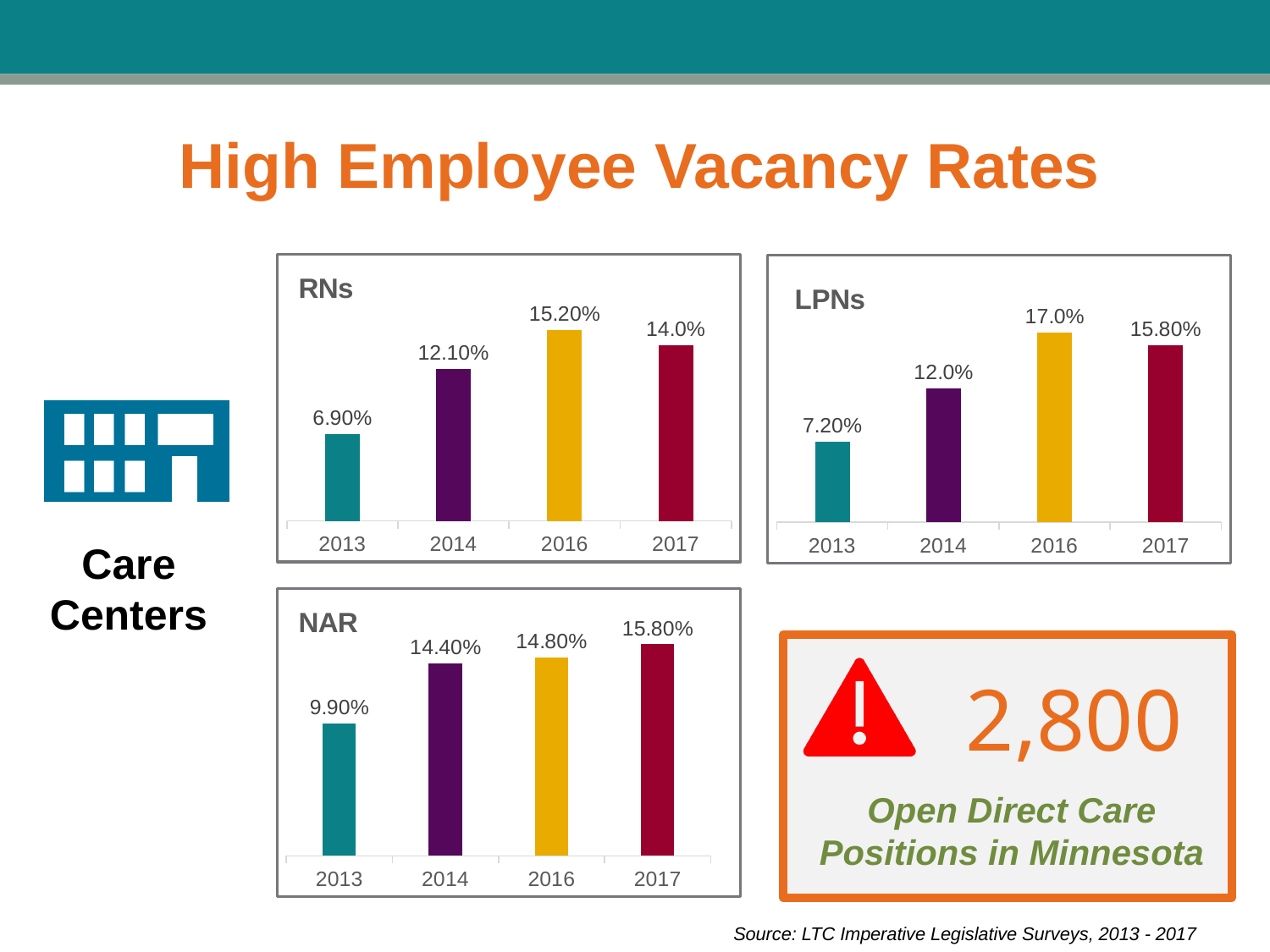
In the RNs chart, what is the difference between the 2016 and 2013 vacancy rates? 8.30% What is the title of the chart in the bottom-left of the slide? NAR What kind of chart is the LPNs chart? bar chart In the RNs chart, what is the vacancy rate for 2016? 15.20% In the LPNs chart, what is the vacancy rate for 2013? 7.20% In the NAR chart, what is the vacancy rate for 2014? 14.40% In the LPNs chart, what is the difference between the 2017 and 2014 vacancy rates? 3.80% In the NAR chart, which is larger, the value for 2017 or the value for 2013? 2017 In the NAR chart, which year has the lowest vacancy rate? 2013 In the LPNs chart, which year has the highest vacancy rate? 2016 How many years are shown on the x axis of the RNs chart? 4 In the NAR chart, do the values rise or fall from 2013 to 2017? rise